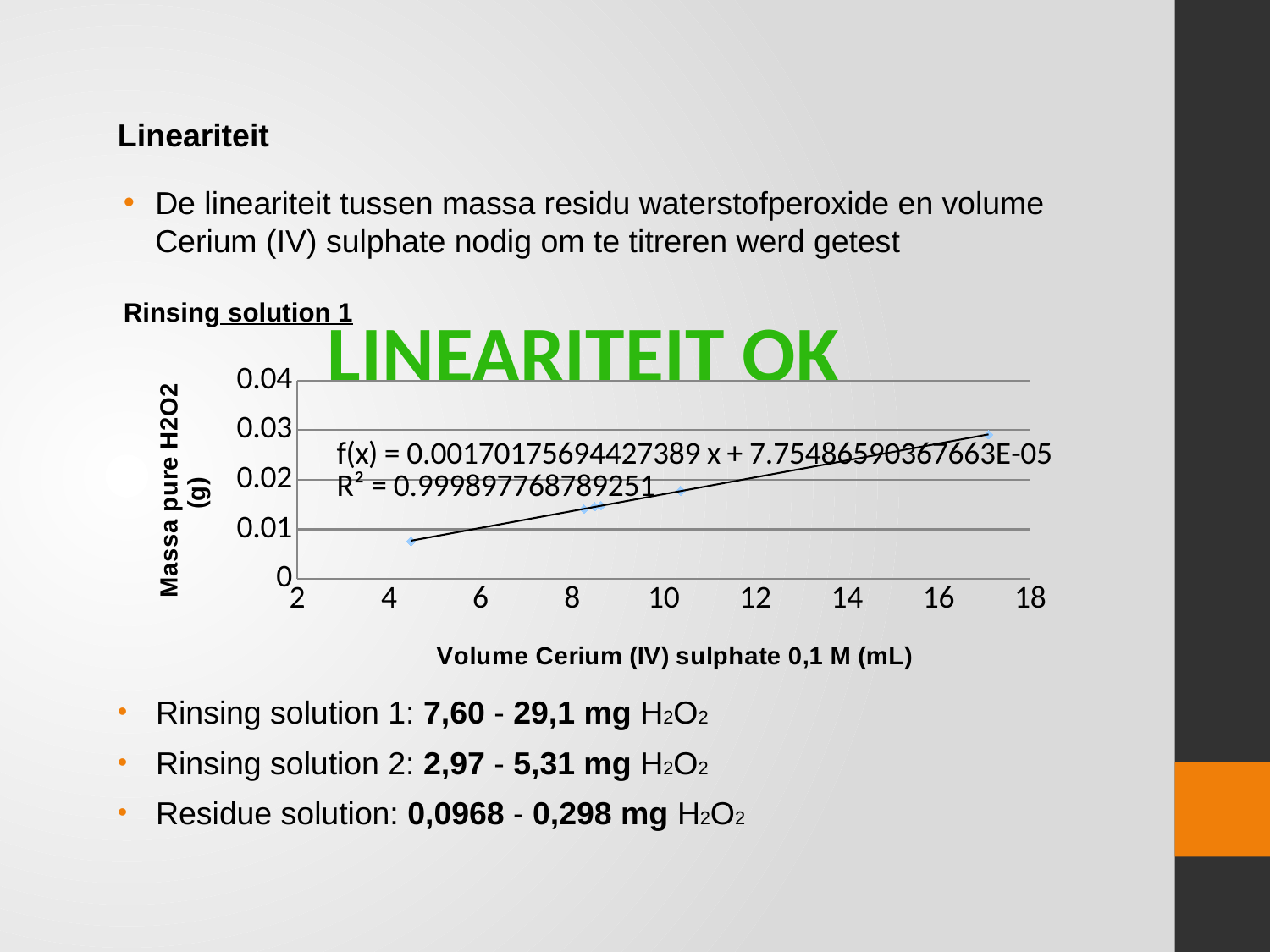
What is the label of the x axis of the chart? Volume Cerium (IV) sulphate 0,1 M (mL) Is the mass value of the data point near 8 mL greater or less than 0.02? less Which data point has the highest mass of pure H2O2: the one at the smallest volume or the one at the largest volume? The one at the largest volume What is the R² value printed on the chart? 0.999897768789251 Do the plotted mass values rise or fall as the volume of Cerium (IV) sulphate increases? Rise What kind of chart is shown on the slide? Scatter chart with a trendline What is the trendline equation printed on the chart? f(x) = 0.00170175694427389 x + 7.75486590367663E-05 What is the title of the chart? LINEARITEIT OK Is the mass value of the rightmost data point (near 17 mL) greater or less than 0.02? greater What is the highest value shown on the y axis of the chart? 0.04 Is the mass value of the leftmost data point (near 4.5 mL) greater or less than 0.01? less